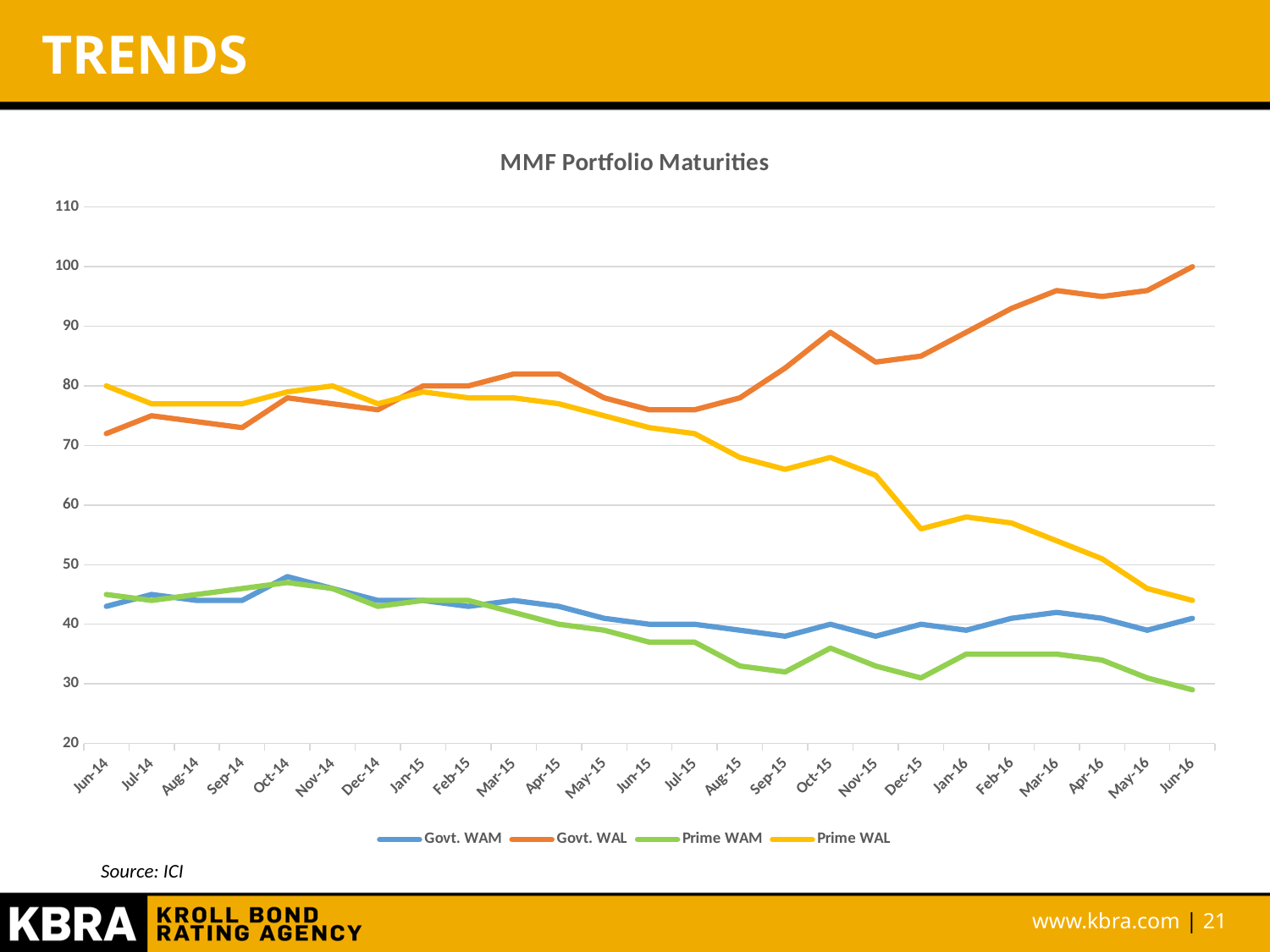
What is the title of the chart? MMF Portfolio Maturities Which series has the highest value in Jun-16? Govt. WAL How many months are plotted along the x axis? 25 What is the value of Govt. WAL in Jun-16? 100 What kind of chart is shown on the slide? line chart Does the Prime WAL series rise or fall overall from Jun-14 to Jun-16? fall Which series has the lowest value in Jun-16? Prime WAM Is the value of Govt. WAL in Oct-15 greater or less than 80? greater What is the value of Prime WAL in Jun-14? 80 Is the value of Prime WAL in Jun-16 greater or less than 50? less Is the value of Prime WAM in Jun-16 greater or less than 40? less How many series does the legend list? 4